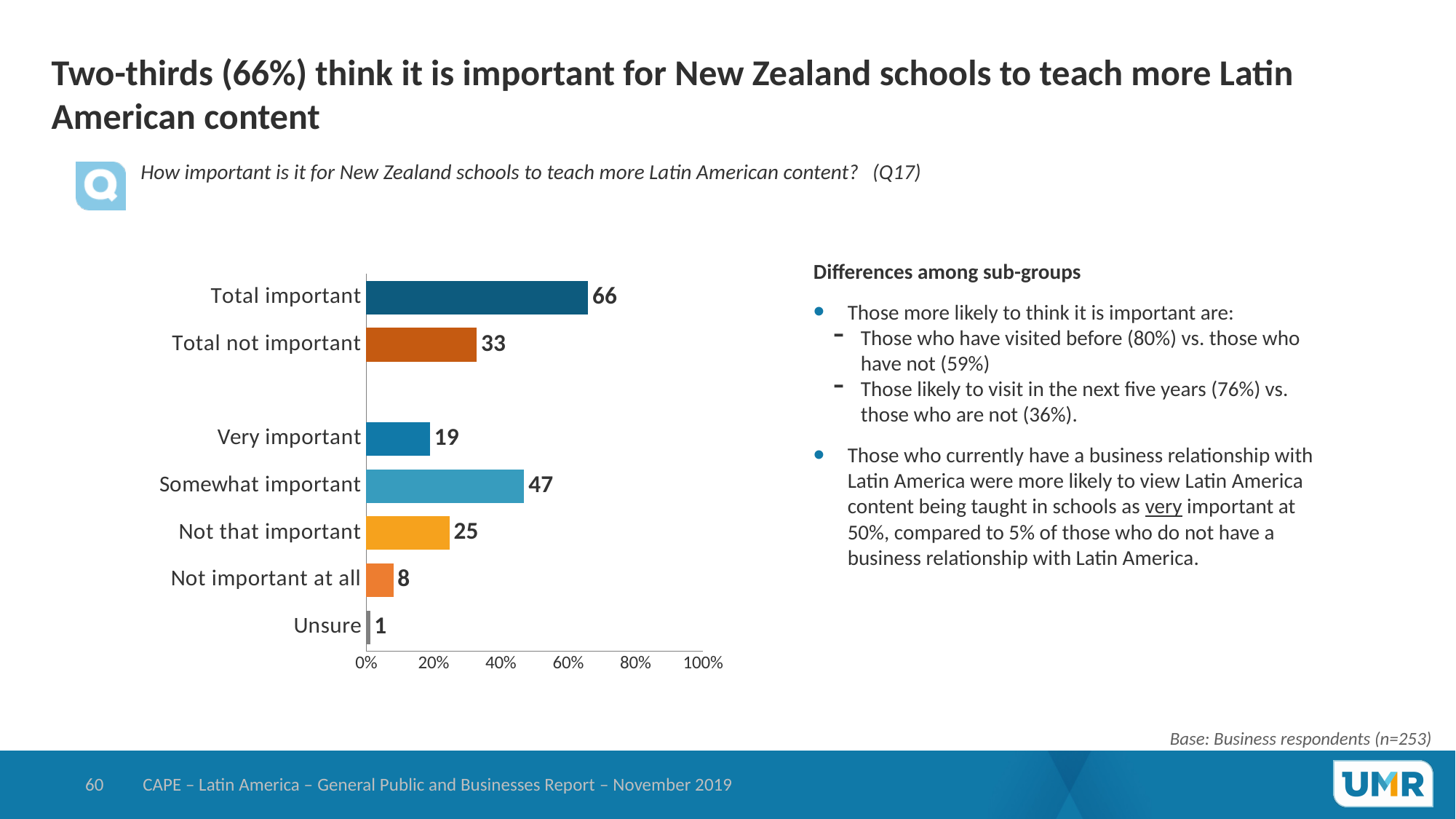
Which category has the highest value? Total important What is the difference between Somewhat important and Very important? 28 What is the value for Unsure? 1 What is the difference between Total important and Total not important? 33 How many categories are shown in the chart? 7 What is the value for Somewhat important? 47 Which is larger, Not that important or Very important? Not that important What is the value for Total important? 66 Which category has the lowest value? Unsure What kind of chart is shown on the slide? Bar chart Is the value for Somewhat important greater or less than 40%? greater What is the value for Not important at all? 8